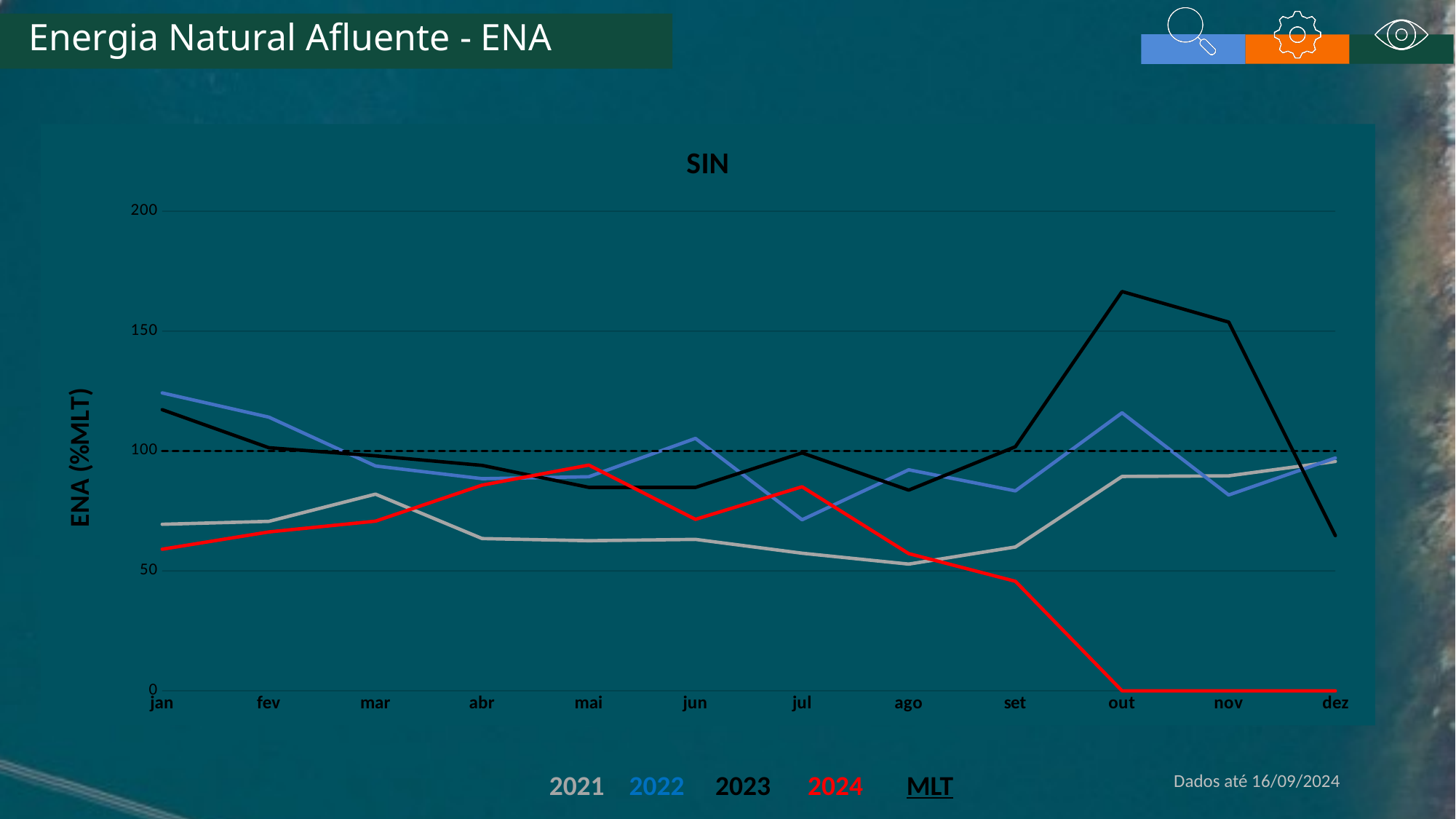
At what value does the dashed MLT line sit? 100 What is the title of the chart? SIN Is the value for 2021 in ago greater or less than 100? less Is the value for 2022 in jan greater or less than 100? greater Is the value for 2023 in out greater or less than 150? greater What is the label of the y axis? ENA (%MLT) In which month does the 2023 series reach its highest value? out What kind of chart is shown on the slide? line chart How many months are shown on the x axis? 12 How many series does the legend list? 5